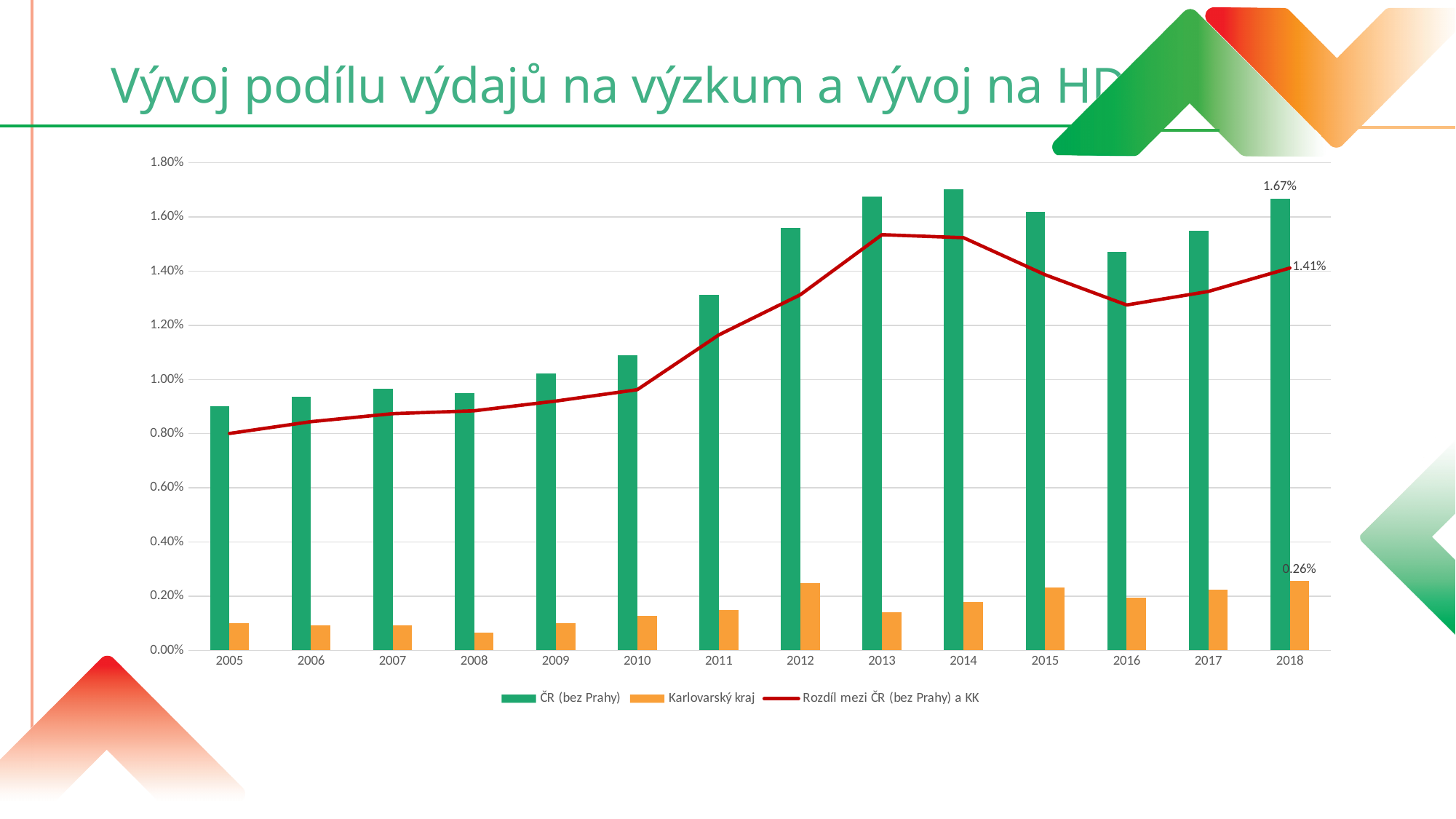
What is the difference between the ČR (bez Prahy) value and the Karlovarský kraj value in 2018? 1.41% How many years are shown on the x axis? 14 How many series does the legend list? 3 What is the value for Karlovarský kraj in 2018? 0.26% What is the value of the line 'Rozdíl mezi ČR (bez Prahy) a KK' in 2018? 1.41% Does the line 'Rozdíl mezi ČR (bez Prahy) a KK' rise or fall from 2005 to 2013? rise Which is larger for ČR (bez Prahy): the value in 2015 or the value in 2016? 2015 Is the value for Karlovarský kraj in 2013 greater or less than 0.20%? less What is the value for ČR (bez Prahy) in 2018? 1.67% Is the value for ČR (bez Prahy) in 2011 greater or less than 1.20%? greater In which year is the ČR (bez Prahy) value the lowest? 2005 In which year is the Karlovarský kraj value the lowest? 2008